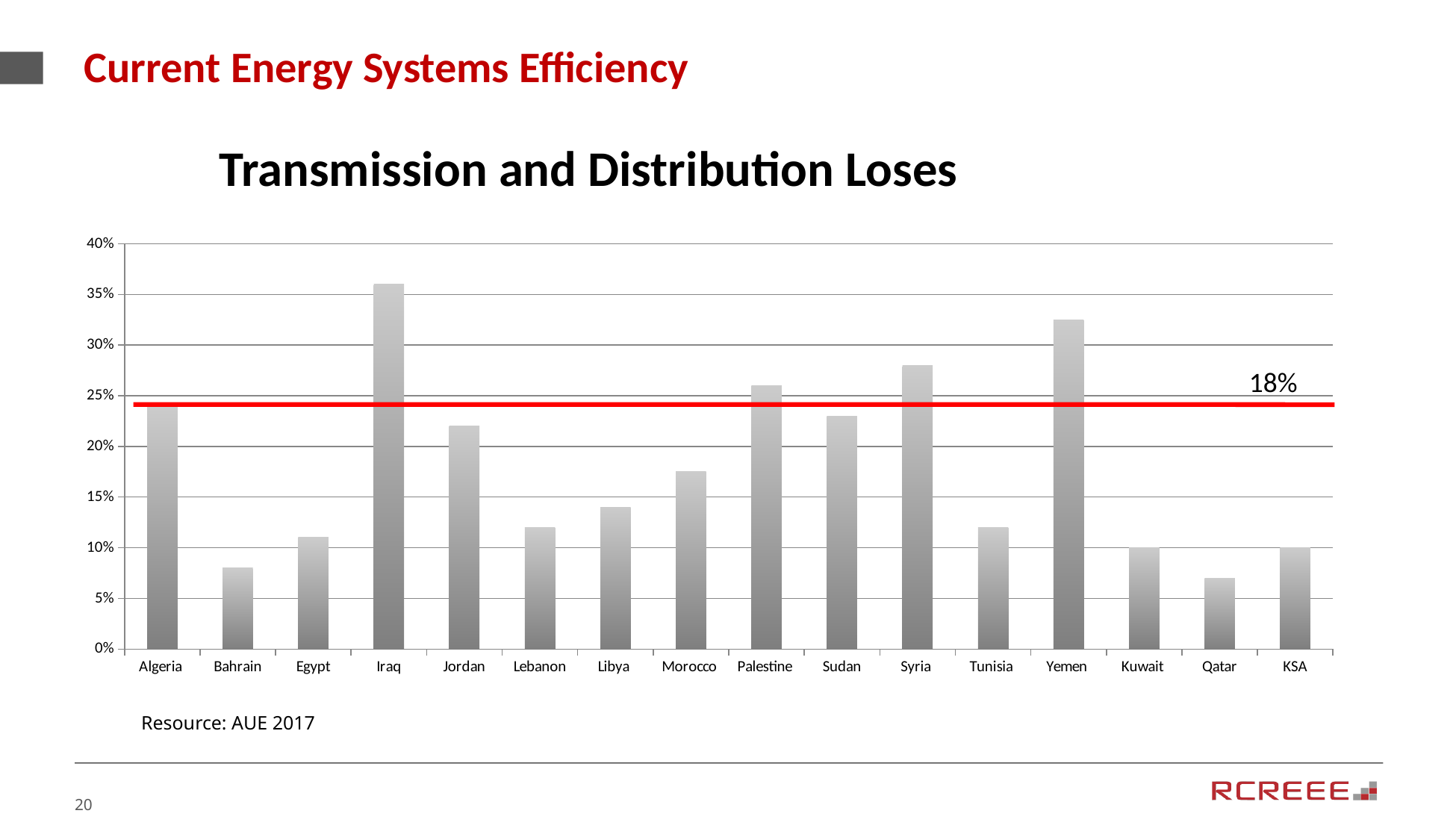
Which has higher losses, Libya or Lebanon? Libya What kind of chart is shown on the slide? bar chart What value is labelled on the red horizontal line? 18% Is the value for Morocco greater or less than 15%? greater Which country has the highest transmission and distribution losses? Iraq Is the value for Bahrain greater or less than 10%? less How many countries are shown on the x axis? 16 Which country has the lowest transmission and distribution losses? Qatar Is the value for Yemen greater or less than 30%? greater Which has higher losses, Syria or Palestine? Syria